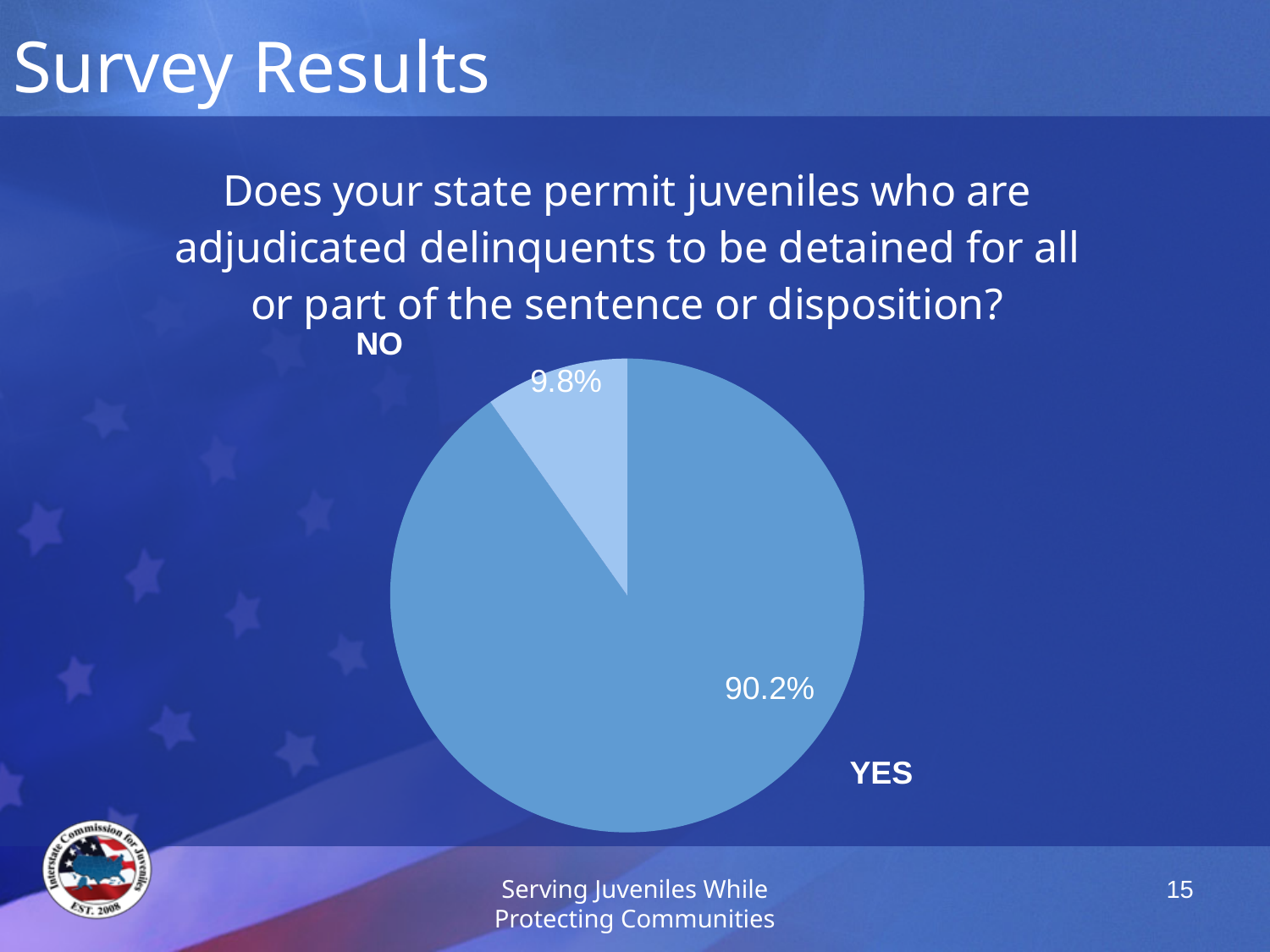
Which response has the smallest share of the pie? NO What percentage of respondents answered YES? 90.2% Which slice is shown in the lighter blue colour? NO What share of the pie does the YES slice represent? 90.2% Which response has the largest share of the pie? YES What is the difference in percentage points between the YES and NO shares? 80.4 Which is larger, the YES share or the NO share? YES How many slices does the pie chart have? 2 What survey question does the pie chart present results for? Does your state permit juveniles who are adjudicated delinquents to be detained for all or part of the sentence or disposition? What kind of chart is shown on the slide? pie chart What percentage of respondents answered NO? 9.8%